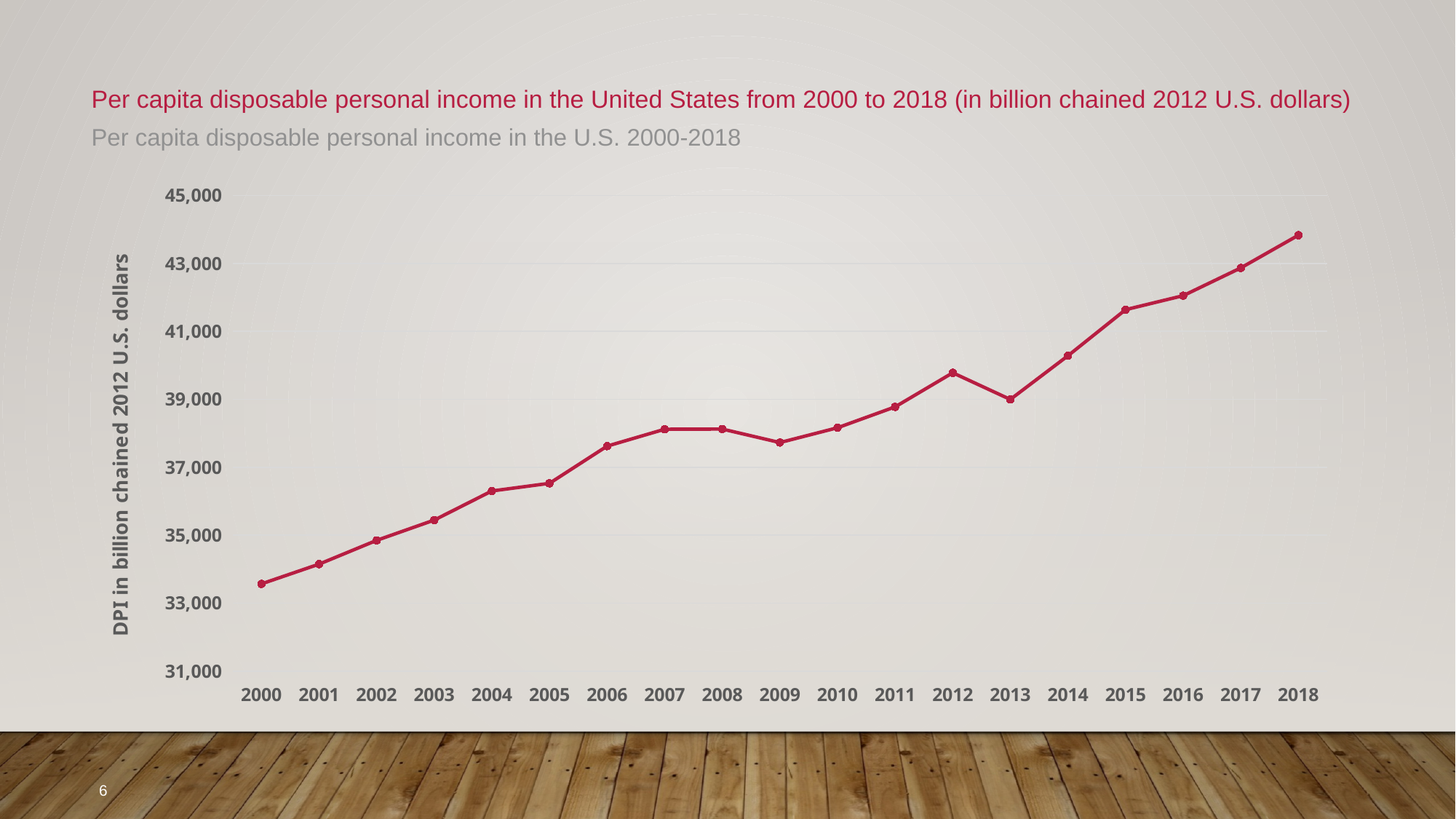
Is the value for 2015 greater or less than 41,000? greater Overall, do the values rise or fall from 2000 to 2018? rise Is the value for 2005 greater or less than 37,000? less Which year has the highest per capita disposable personal income? 2018 How many years (data points) are plotted on the x axis? 19 Is the value for 2000 greater or less than 35,000? less What kind of chart is shown on the slide? line chart What is the title of the vertical axis? DPI in billion chained 2012 U.S. dollars Which year has the lowest per capita disposable personal income? 2000 Which year has the larger value, 2012 or 2013? 2012